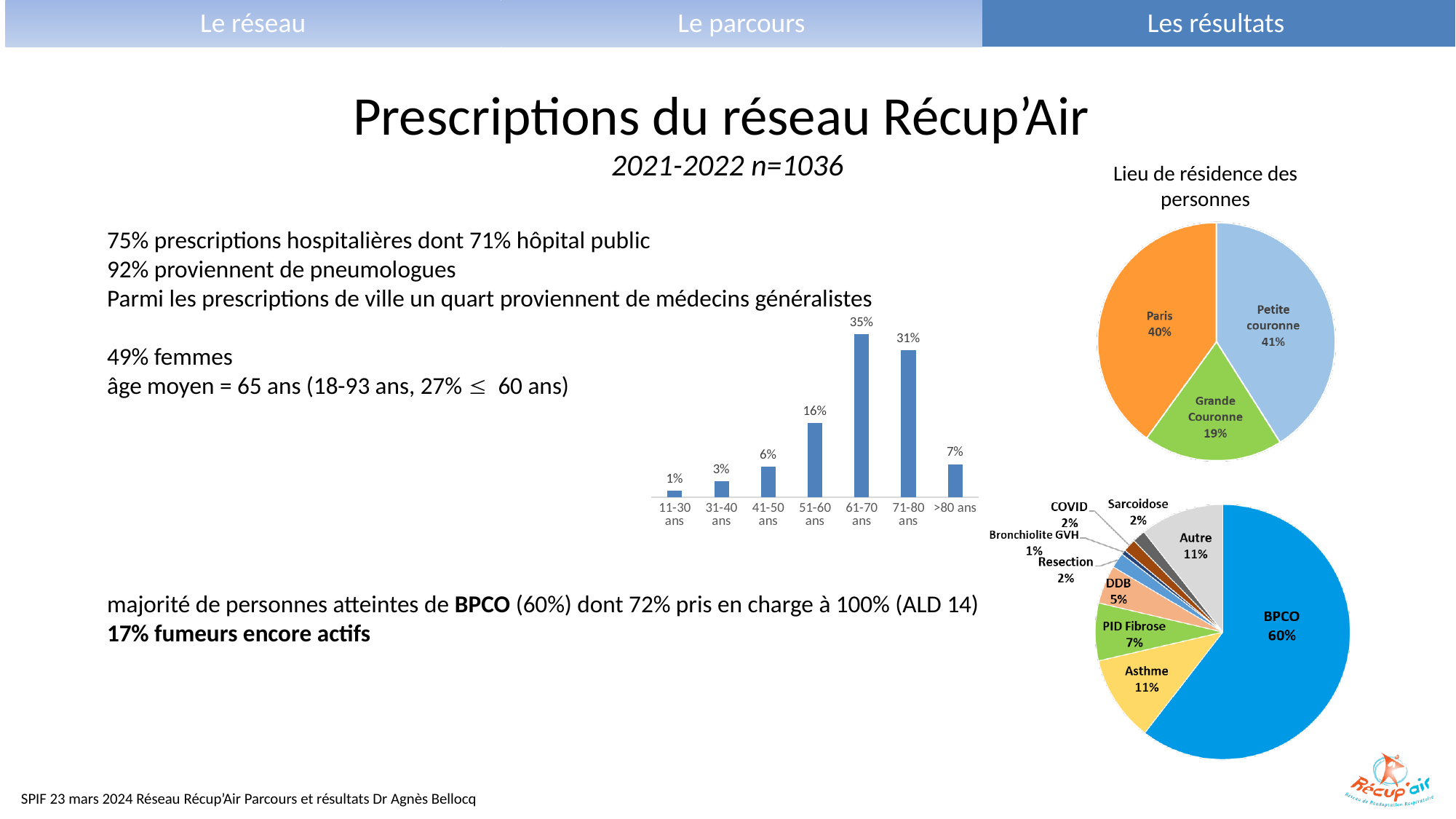
In the age-group bar chart in the middle of the slide, what is the difference between the 61-70 ans and 71-80 ans values? 4% In the age-group bar chart in the middle of the slide, which age group has the lowest value? 11-30 ans In the 'Lieu de résidence des personnes' pie chart, what share is Grande Couronne? 19% What kind of chart is the age-group chart in the middle of the slide? Bar chart In the age-group bar chart in the middle of the slide, which age group has the highest value? 61-70 ans In the diagnosis pie chart at the bottom right of the slide, what is the value for PID Fibrose? 7% In the diagnosis pie chart at the bottom right of the slide, what share is BPCO? 60% In the 'Lieu de résidence des personnes' pie chart, which is larger, Paris or Petite couronne? Petite couronne In the age-group bar chart in the middle of the slide, how many age groups are shown? 7 In the age-group bar chart in the middle of the slide, what is the value for the 61-70 ans group? 35% In the diagnosis pie chart at the bottom right of the slide, which slice is the smallest? Bronchiolite GVH In the 'Lieu de résidence des personnes' pie chart, how many slices are there? 3